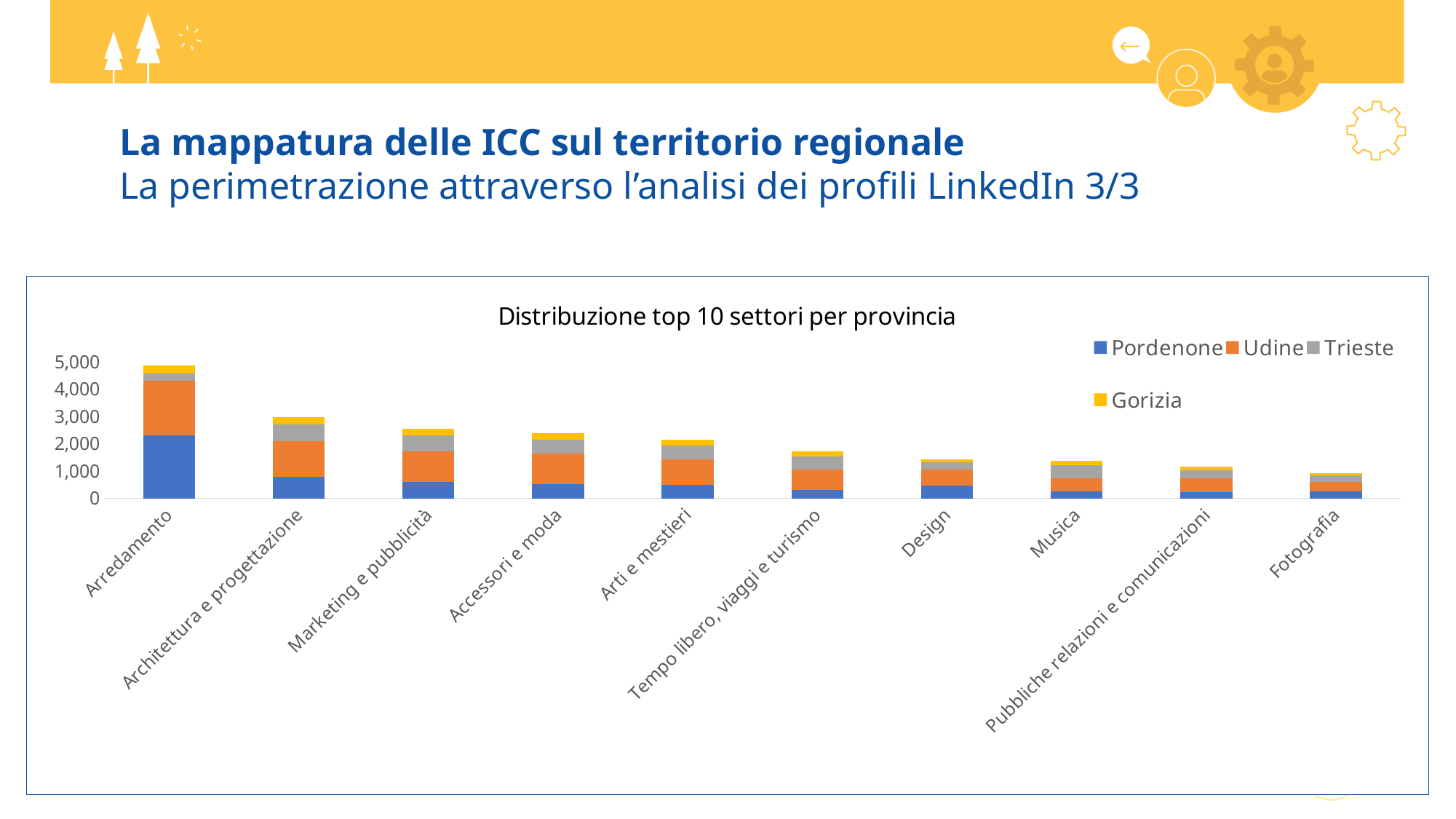
Which sector has the shortest stacked bar? Fotografia Which sector has the tallest stacked bar? Arredamento Which has the larger total stacked bar, Musica or Fotografia? Musica How many series does the legend list? 4 Is the total stacked value for Marketing e pubblicità greater or less than 2,000? greater What is the title of the chart? Distribuzione top 10 settori per provincia How many sector categories are shown on the x axis? 10 What kind of chart is shown on the slide? Stacked bar chart Is the Pordenone value for Arredamento greater or less than 2,000? greater Do the total stacked values rise or fall moving from left to right along the x axis? fall Is the total stacked value for Arredamento greater or less than 4,000? greater